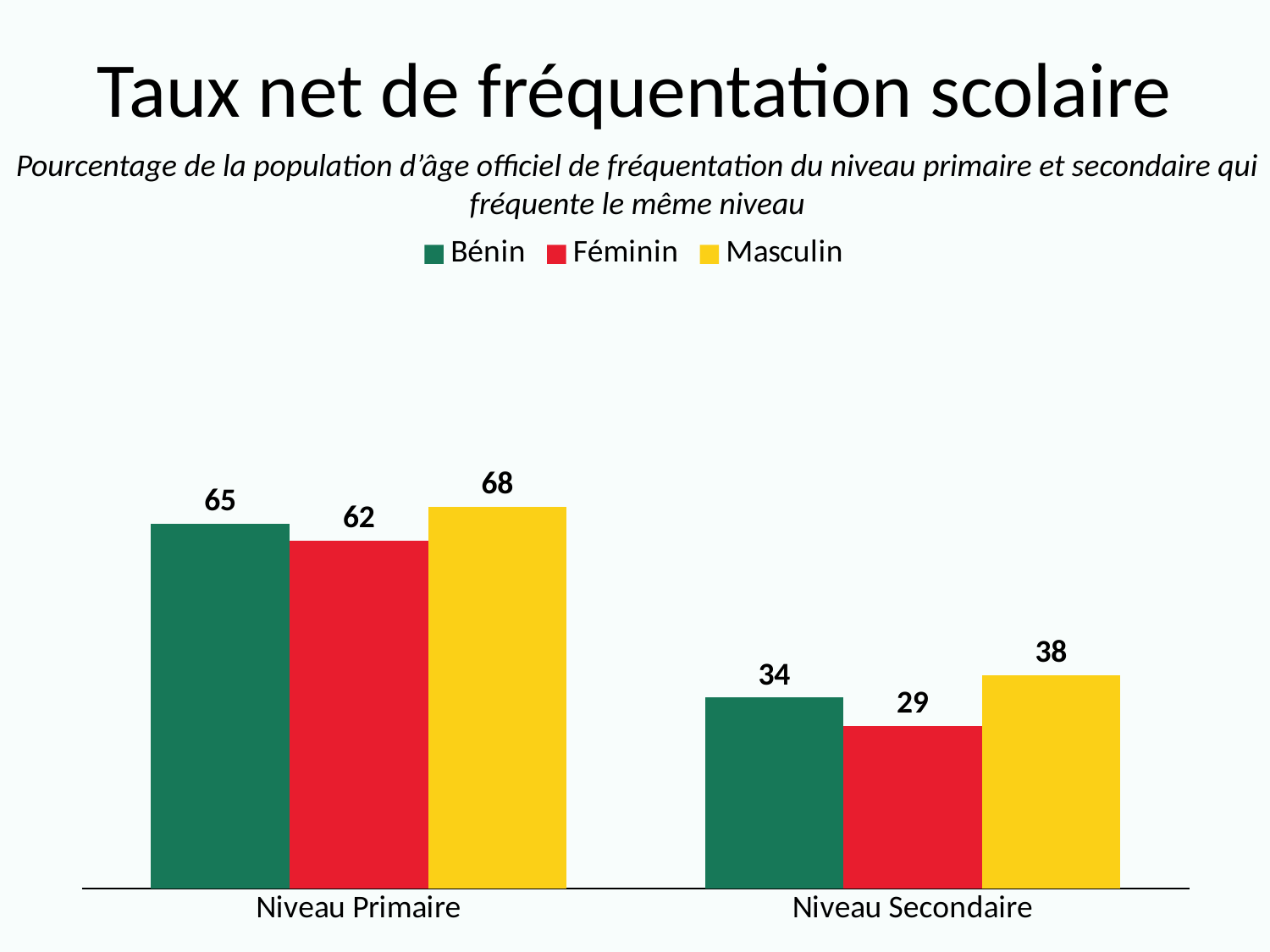
What is the title of the chart? Taux net de fréquentation scolaire What is the value for Bénin at Niveau Primaire? 65 What is the difference between the Masculin and Féminin values at Niveau Secondaire? 9 Which is larger: the Féminin value at Niveau Primaire or the Masculin value at Niveau Secondaire? Féminin at Niveau Primaire What is the value for Masculin at Niveau Primaire? 68 What kind of chart is shown on the slide? Bar chart What is the value for Féminin at Niveau Secondaire? 29 How many series does the legend list? 3 Which series has the lowest value at Niveau Primaire? Féminin How many categories are shown on the x axis? 2 Which series has the highest value at Niveau Secondaire? Masculin What is the difference between the Bénin values for Niveau Primaire and Niveau Secondaire? 31